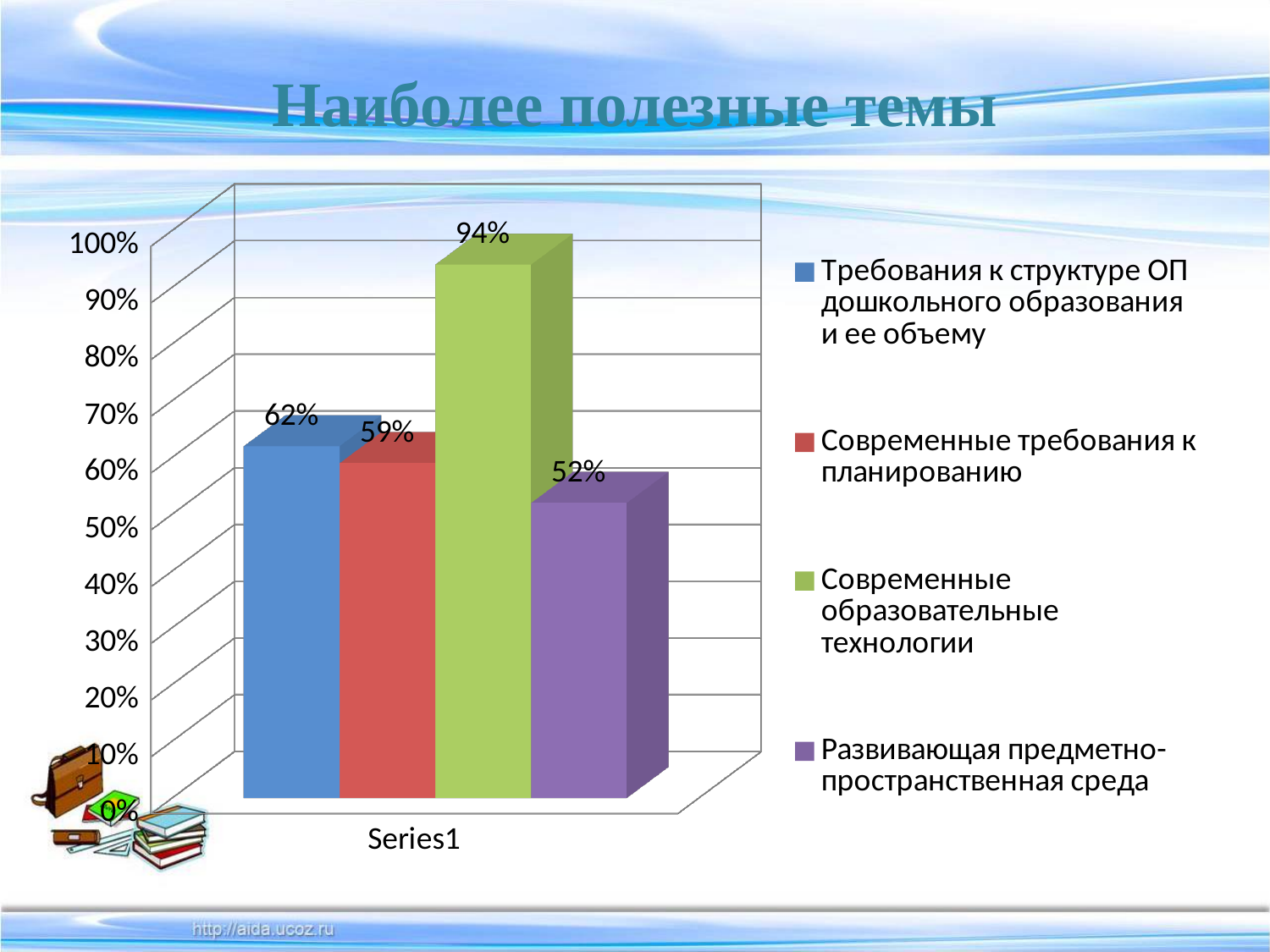
What is the value for "Современные требования к планированию"? 59% What is the value for "Требования к структуре ОП дошкольного образования и ее объему"? 62% Which series has the highest value? Современные образовательные технологии How many series does the legend list? 4 What is the value for "Развивающая предметно-пространственная среда"? 52% What is the value for "Современные образовательные технологии"? 94% What is the difference between the values for "Современные образовательные технологии" and "Развивающая предметно-пространственная среда"? 42% Which series has the lowest value? Развивающая предметно-пространственная среда What is the title of the slide containing the chart? Наиболее полезные темы What is the difference between the values for "Требования к структуре ОП дошкольного образования и ее объему" and "Современные требования к планированию"? 3% Which is larger: the value for "Современные требования к планированию" or for "Развивающая предметно-пространственная среда"? Современные требования к планированию What kind of chart is shown on the slide? Bar chart